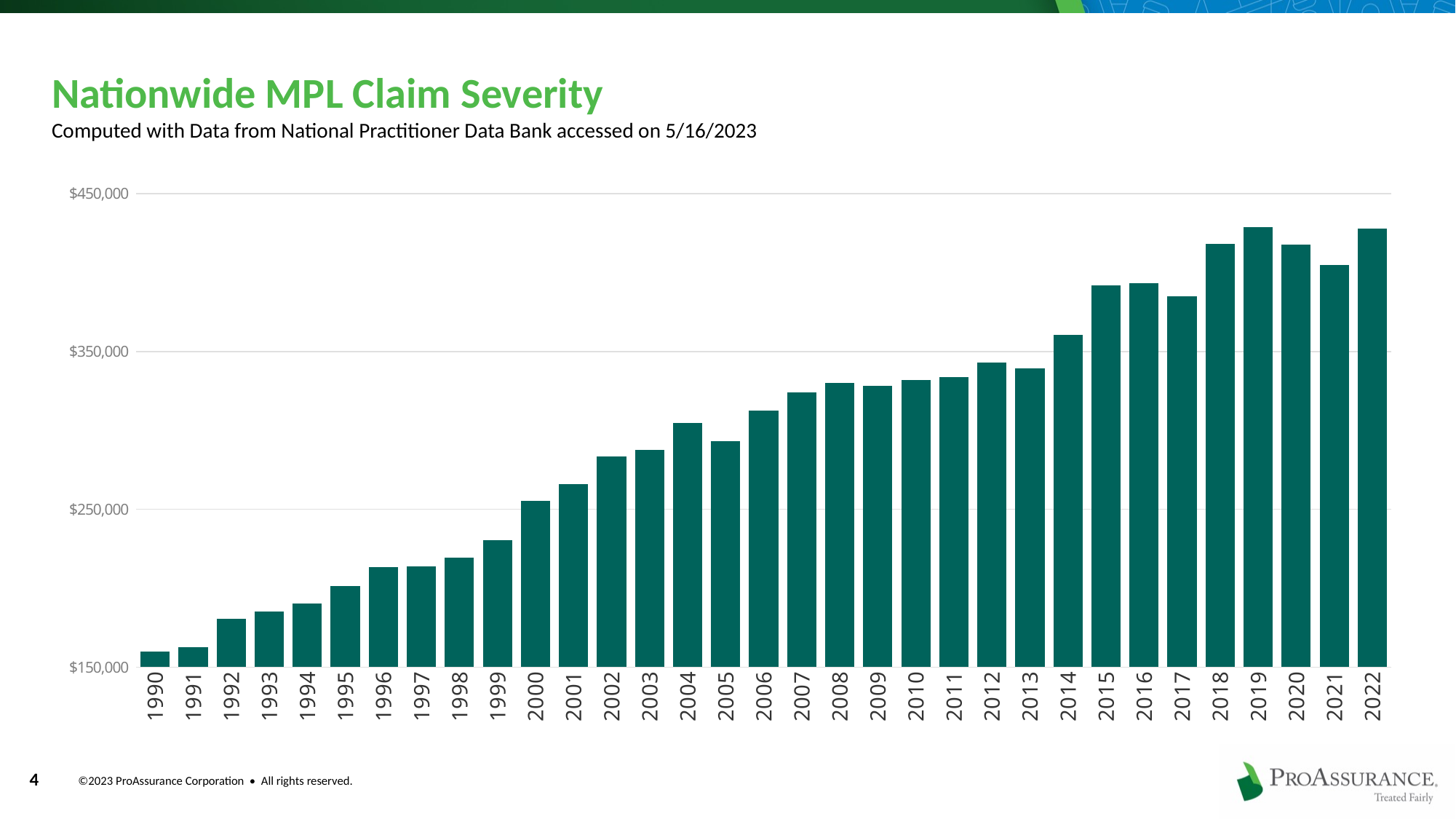
Which year has the lowest claim severity? 1990 Which year has the higher claim severity, 2004 or 2005? 2004 Is the value for 1999 greater or less than $250,000? less Overall, do the values rise or fall from 1990 to 2022? rise Which year has the higher claim severity, 2017 or 2018? 2018 Is the value for 1990 greater or less than $250,000? less Is the value for 2014 greater or less than $350,000? greater How many years are plotted on the chart? 33 What is the title of the chart on the slide? Nationwide MPL Claim Severity What kind of chart is shown on the slide? bar chart